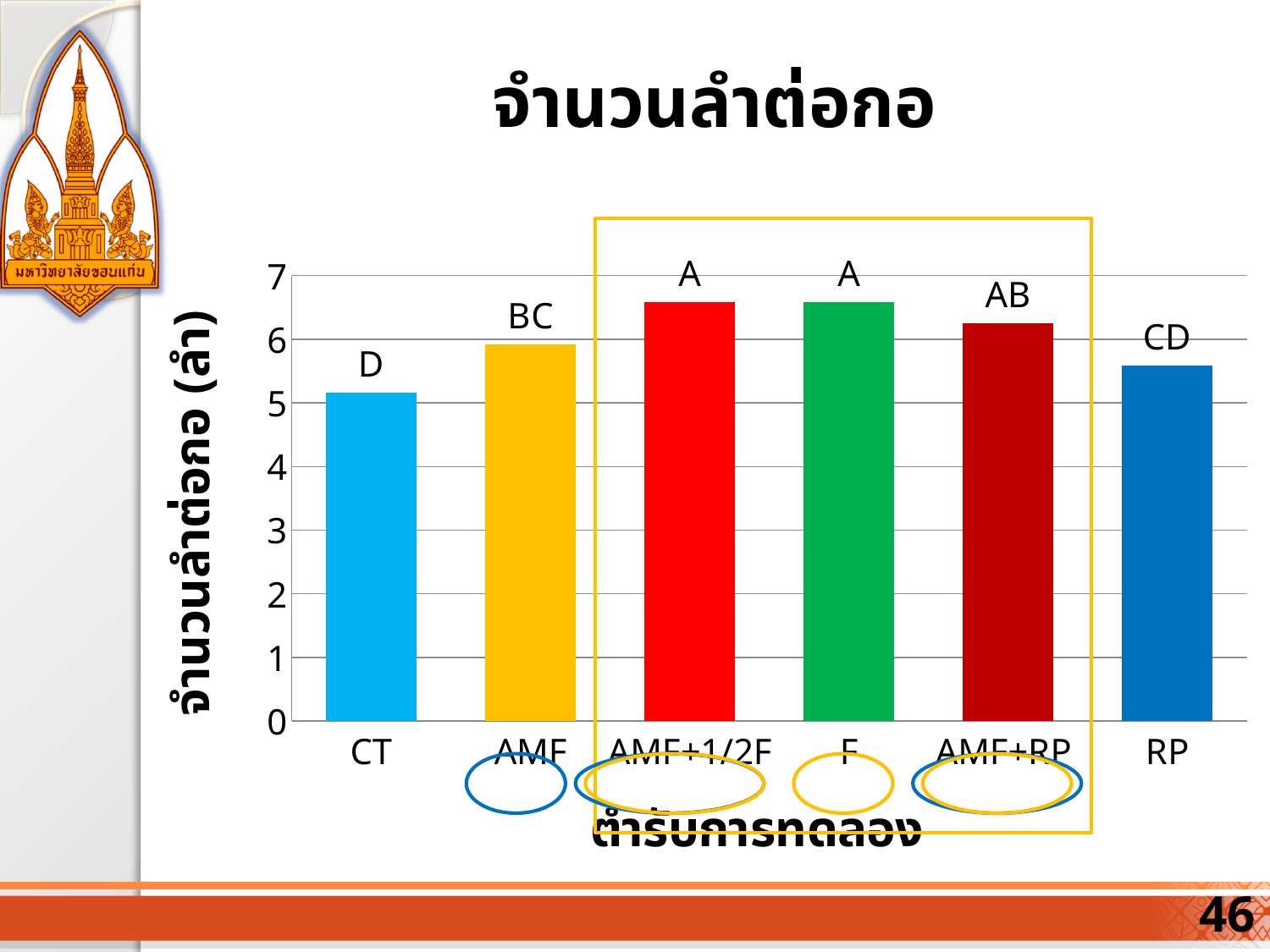
What is the title of the chart? จำนวนลำต่อกอ Which has a larger value, AMF or AMF+RP? AMF+RP How many categories (treatments) are shown on the x axis of the chart? 6 Is the value for RP greater or less than 6? less Is the value for CT greater or less than 5? greater Which treatment has the lowest number of stalks per clump in the chart? CT What letter label is printed above the CT bar? D Is the value for F greater or less than 6? greater What kind of chart is shown on the slide? bar chart Which has a larger value, CT or RP? RP